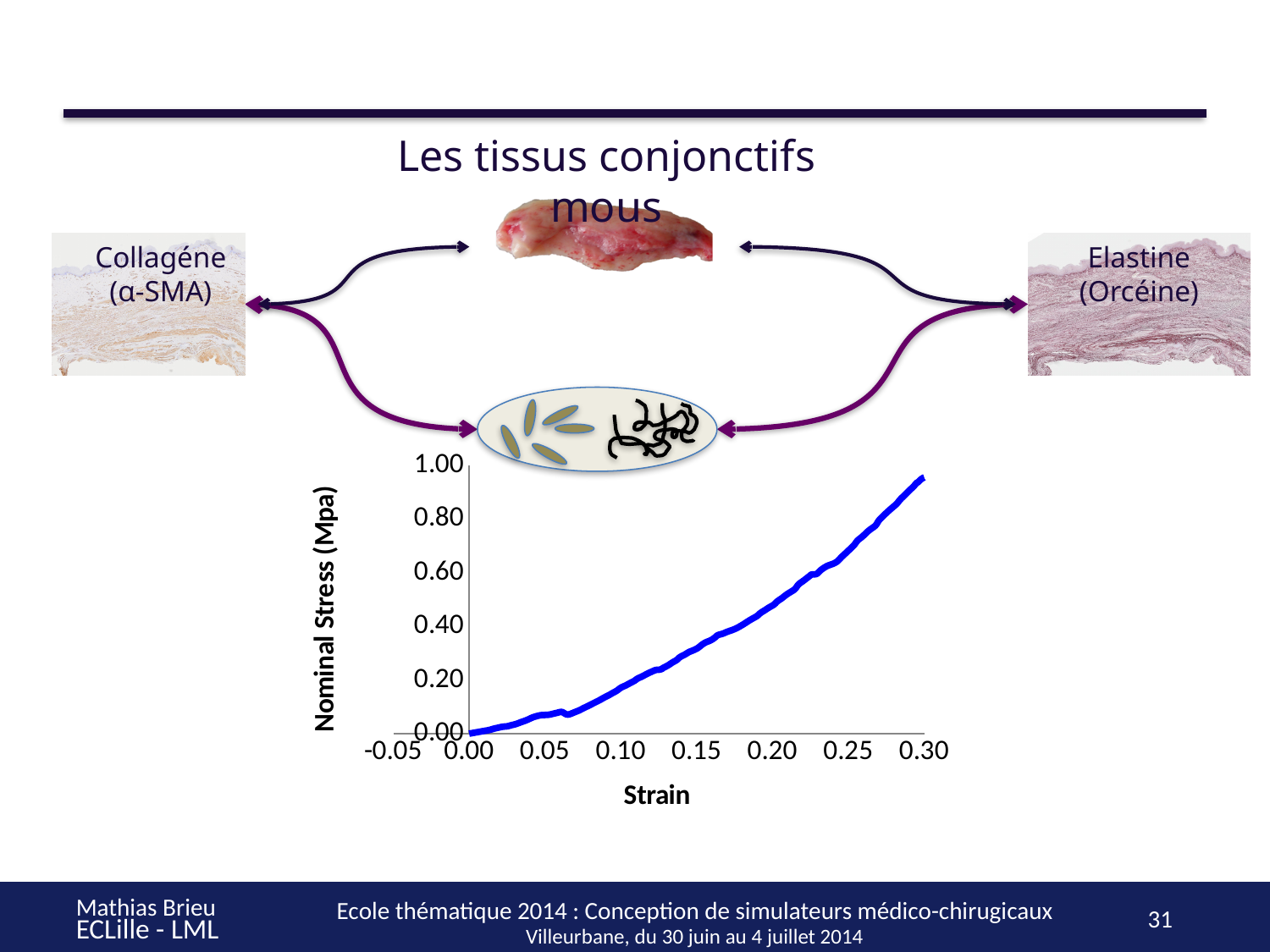
What is the label of the y axis of the chart? Nominal Stress (Mpa) Is the nominal stress at a strain of 0.05 greater or less than 0.20? less Is the nominal stress at a strain of 0.20 greater or less than 0.40? greater Is the nominal stress at a strain of 0.25 greater or less than 0.60? greater Which strain value shows the higher nominal stress, 0.10 or 0.25? 0.25 Does the nominal stress rise or fall as strain increases along the x axis? rise What is the label of the x axis of the chart? Strain What is the highest strain value shown on the x axis? 0.30 What kind of chart is shown on the slide? line chart